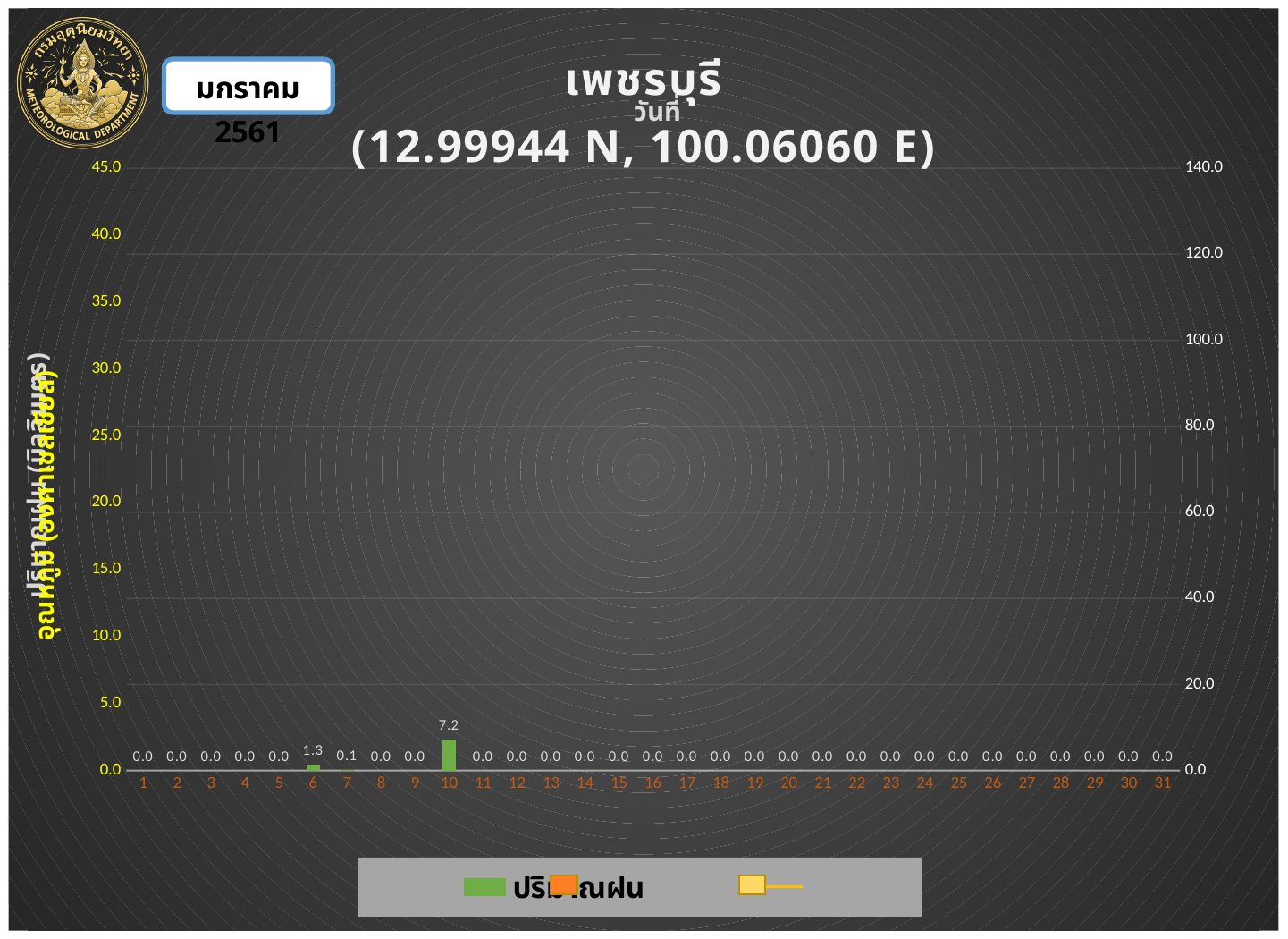
What is the highest value shown on the right-hand axis? 140.0 What is the rainfall value shown for day 20? 0.0 What is the difference between the rainfall values for day 6 and day 7? 1.2 What is the rainfall value shown for day 6? 1.3 What kind of chart is shown on the slide? bar chart What is the rainfall value shown for day 7? 0.1 What is the difference between the rainfall values for day 10 and day 6? 5.9 Which has a larger rainfall value, day 6 or day 7? day 6 What is the rainfall value shown for day 10? 7.2 Is the rainfall value for day 10 greater or less than 10.0 on the left axis? less Which day has the highest rainfall value? 10 How many days are shown on the x axis? 31